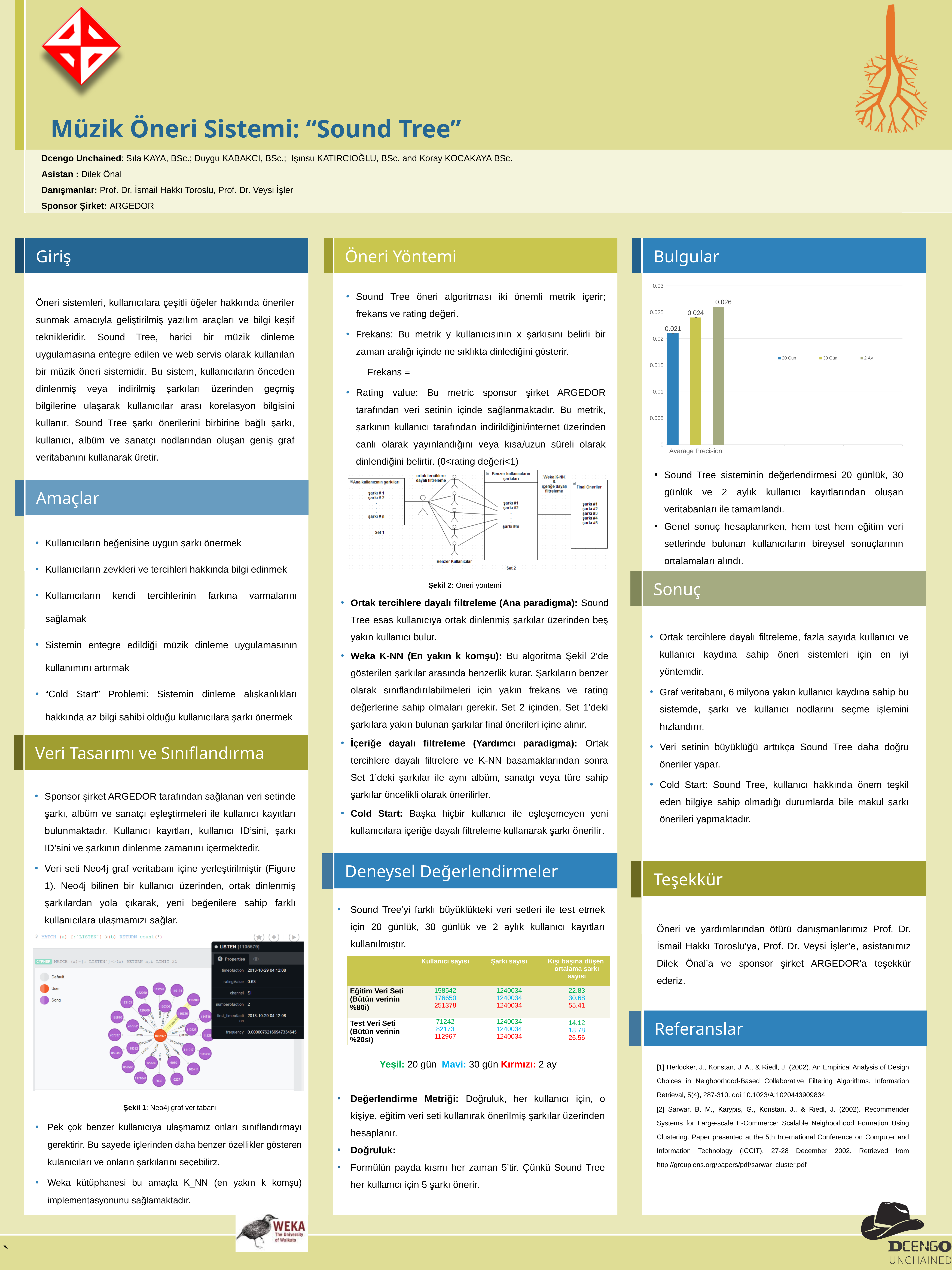
What is the value for the 20 Gün series in the Avarage Precision chart? 0.021 Which series has the highest value in the Avarage Precision chart? 2 Ay What is the value for the 2 Ay series in the Avarage Precision chart? 0.026 What is the category label on the x axis of the chart in the Bulgular section? Avarage Precision What is the difference between the 2 Ay and 20 Gün values in the Avarage Precision chart? 0.005 What is the value for the 30 Gün series in the Avarage Precision chart? 0.024 What is the maximum value shown on the y axis of the Avarage Precision chart? 0.03 What kind of chart is shown in the Bulgular section? bar chart In the Avarage Precision chart, which is larger: the 30 Gün value or the 20 Gün value? 30 Gün Is the value for 2 Ay in the Avarage Precision chart greater or less than 0.025? greater How many series does the legend of the Avarage Precision chart list? 3 Which series has the lowest value in the Avarage Precision chart? 20 Gün